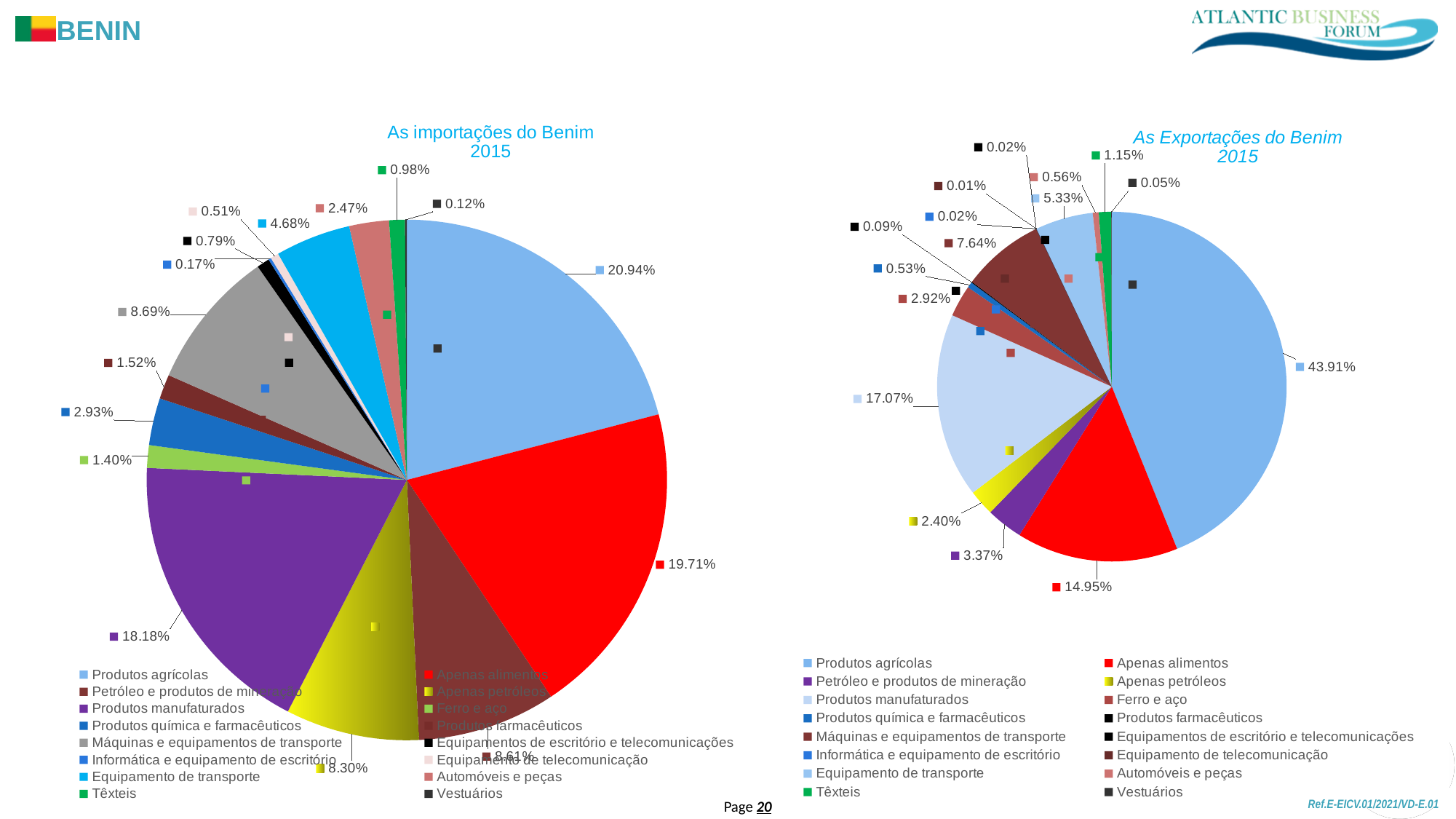
In the chart titled "As Exportações do Benim 2015", which category has the largest slice? Produtos agrícolas In the chart titled "As importações do Benim 2015", what share is shown for Equipamento de transporte? 4.68% In the chart titled "As Exportações do Benim 2015", what share is shown for Máquinas e equipamentos de transporte? 7.64% In the chart titled "As importações do Benim 2015", which category has the largest slice? Produtos agrícolas In the chart titled "As importações do Benim 2015", what share is shown for Produtos agrícolas? 20.94% What type of chart is the chart titled "As importações do Benim 2015"? Pie chart In the chart titled "As importações do Benim 2015", what share is shown for Produtos manufaturados? 18.18% How many categories does the legend of the chart titled "As Exportações do Benim 2015" list? 16 In the chart titled "As importações do Benim 2015", what is the difference between the shares of Produtos agrícolas and Apenas alimentos? 1.23% In the chart titled "As Exportações do Benim 2015", what share is shown for Produtos agrícolas? 43.91% In the chart titled "As Exportações do Benim 2015", which is larger: Produtos manufaturados or Apenas alimentos? Produtos manufaturados In the chart titled "As Exportações do Benim 2015", what share is shown for Apenas alimentos? 14.95%